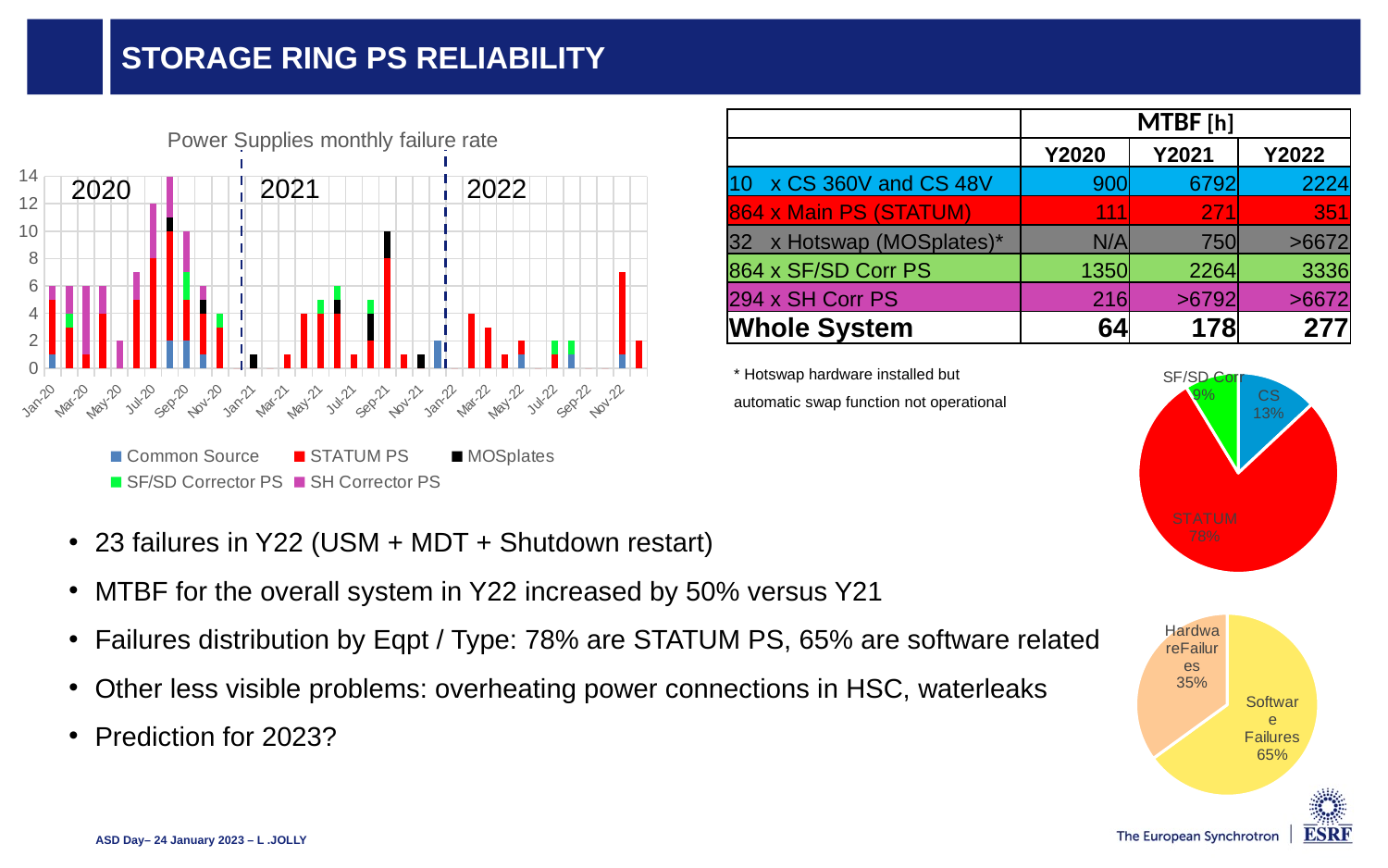
In the "Power Supplies monthly failure rate" chart, which series is shown in red? STATUM PS In the lower pie chart on the right, what share do Software Failures have? 65% In the upper pie chart on the right, what share does CS have? 13% What kind of chart is the "Power Supplies monthly failure rate" chart? bar chart In the upper pie chart on the right, which slice is the smallest? SF/SD Corr In the "Power Supplies monthly failure rate" chart, is the total for Aug-20 greater or less than 10? greater In the "Power Supplies monthly failure rate" chart, which year's bars are labelled first on the left? 2020 In the lower pie chart on the right, which is larger: Hardware Failures or Software Failures? Software Failures How many series does the legend of the "Power Supplies monthly failure rate" chart list? 5 In the "Power Supplies monthly failure rate" chart, is the total for Nov-22 greater or less than 4? greater In the upper pie chart on the right, what is the difference between the STATUM share and the CS share? 65% In the upper pie chart on the right, what share does STATUM have? 78%